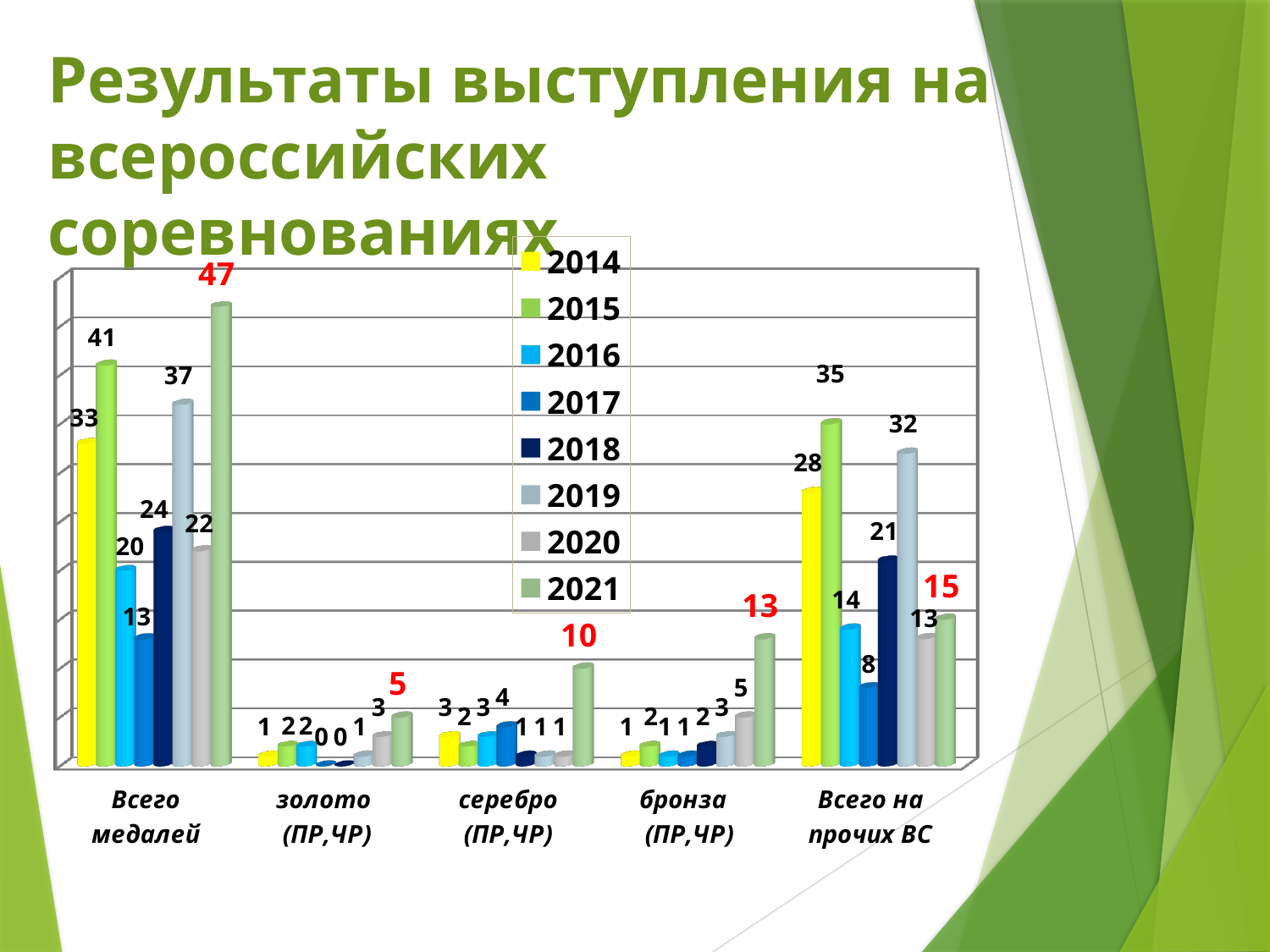
What is the value for 2017 in the category 'серебро (ПР,ЧР)'? 4 Which year's legend entry is shown in yellow? 2014 What is the value for 2021 in the category 'Всего медалей'? 47 What type of chart is shown on the slide? bar chart What is the difference between the 2021 and 2015 values in the category 'Всего медалей'? 6 What is the difference between the 2015 and 2014 values in the category 'Всего на прочих ВС'? 7 How many categories are shown on the x axis? 5 Which year has the lowest value in the category 'Всего на прочих ВС'? 2017 What is the value for 2019 in the category 'Всего на прочих ВС'? 32 How many series does the legend list? 8 In the category 'бронза (ПР,ЧР)', which is larger: the value for 2020 or the value for 2021? 2021 Which year has the highest value in the category 'Всего медалей'? 2021